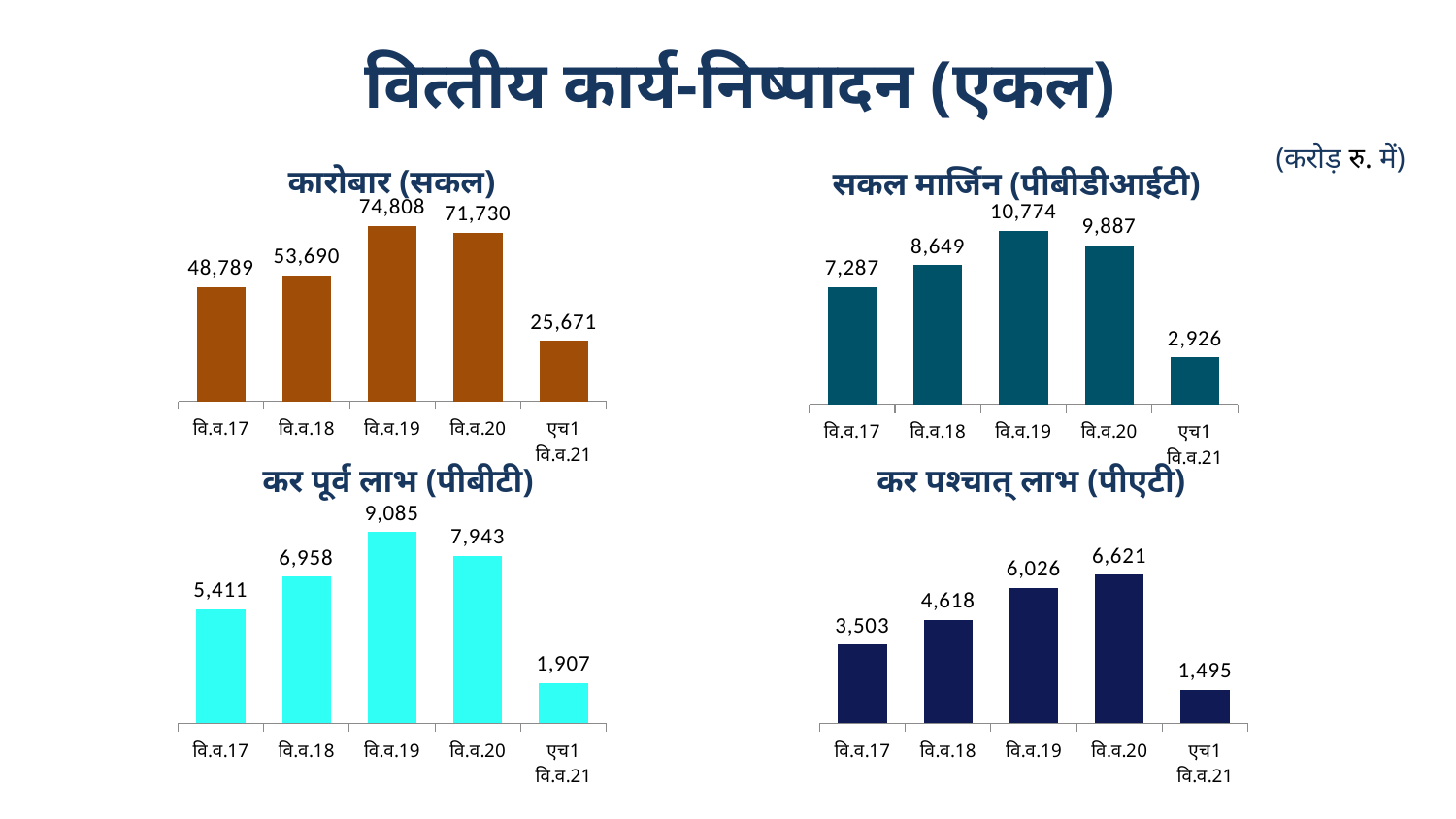
In the top-left chart titled कारोबार (सकल), which category has the lowest value? एच1 वि.व.21 In the top-right chart titled सकल मार्जिन (पीबीडीआईटी), what is the difference between the values for वि.व.19 and वि.व.20? 887 In the top-right chart titled सकल मार्जिन (पीबीडीआईटी), do the values rise or fall from वि.व.17 to वि.व.19? Rise In the bottom-right chart titled कर पश्चात् लाभ (पीएटी), what is the difference between the values for वि.व.20 and वि.व.17? 3,118 What kind of chart is the bottom-right chart titled कर पश्चात् लाभ (पीएटी)? Bar chart In the bottom-left chart titled कर पूर्व लाभ (पीबीटी), which is larger, the value for वि.व.19 or वि.व.20? वि.व.19 In the bottom-left chart titled कर पूर्व लाभ (पीबीटी), what is the value for वि.व.18? 6,958 How many categories are shown on the x axis of the top-left chart titled कारोबार (सकल)? 5 In the bottom-right chart titled कर पश्चात् लाभ (पीएटी), which category has the highest value? वि.व.20 In the top-left chart titled कारोबार (सकल), what is the value for वि.व.19? 74,808 How many charts are shown on the slide? 4 In the top-right chart titled सकल मार्जिन (पीबीडीआईटी), what is the value for एच1 वि.व.21? 2,926